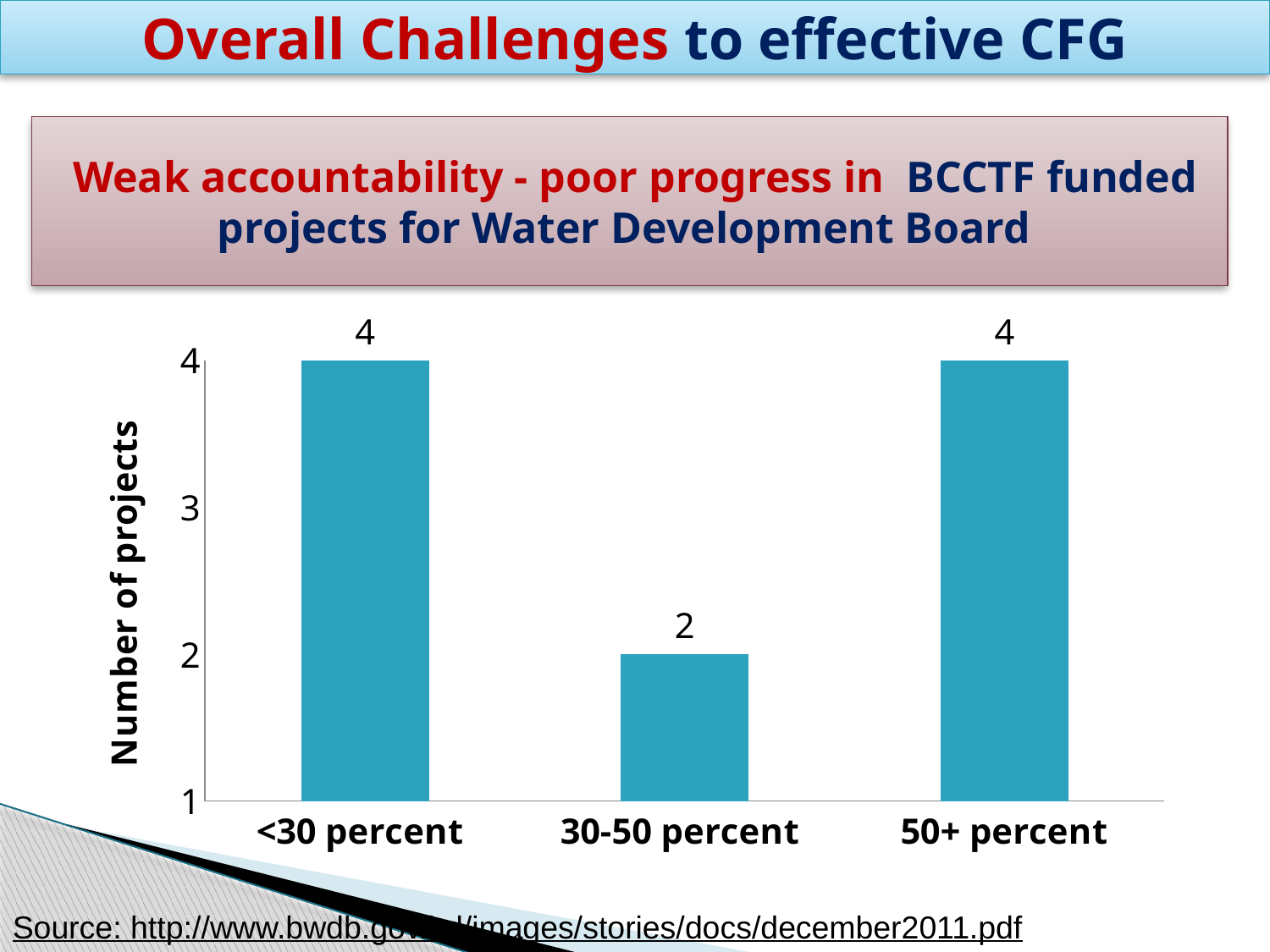
How many categories are shown on the x axis of the chart? 3 What is the label of the vertical axis of the chart? Number of projects What is the total number of projects across all three categories? 10 Which category has the lowest number of projects? 30-50 percent What is the number of projects for the 30-50 percent category? 2 What colour are the bars in the chart? blue What is the number of projects for the 50+ percent category? 4 What is the difference in number of projects between the <30 percent and 30-50 percent categories? 2 Which has more projects, the 30-50 percent category or the 50+ percent category? 50+ percent What is the number of projects for the <30 percent category? 4 Is the value for 30-50 percent greater or less than 3? less What kind of chart is shown on the slide? bar chart